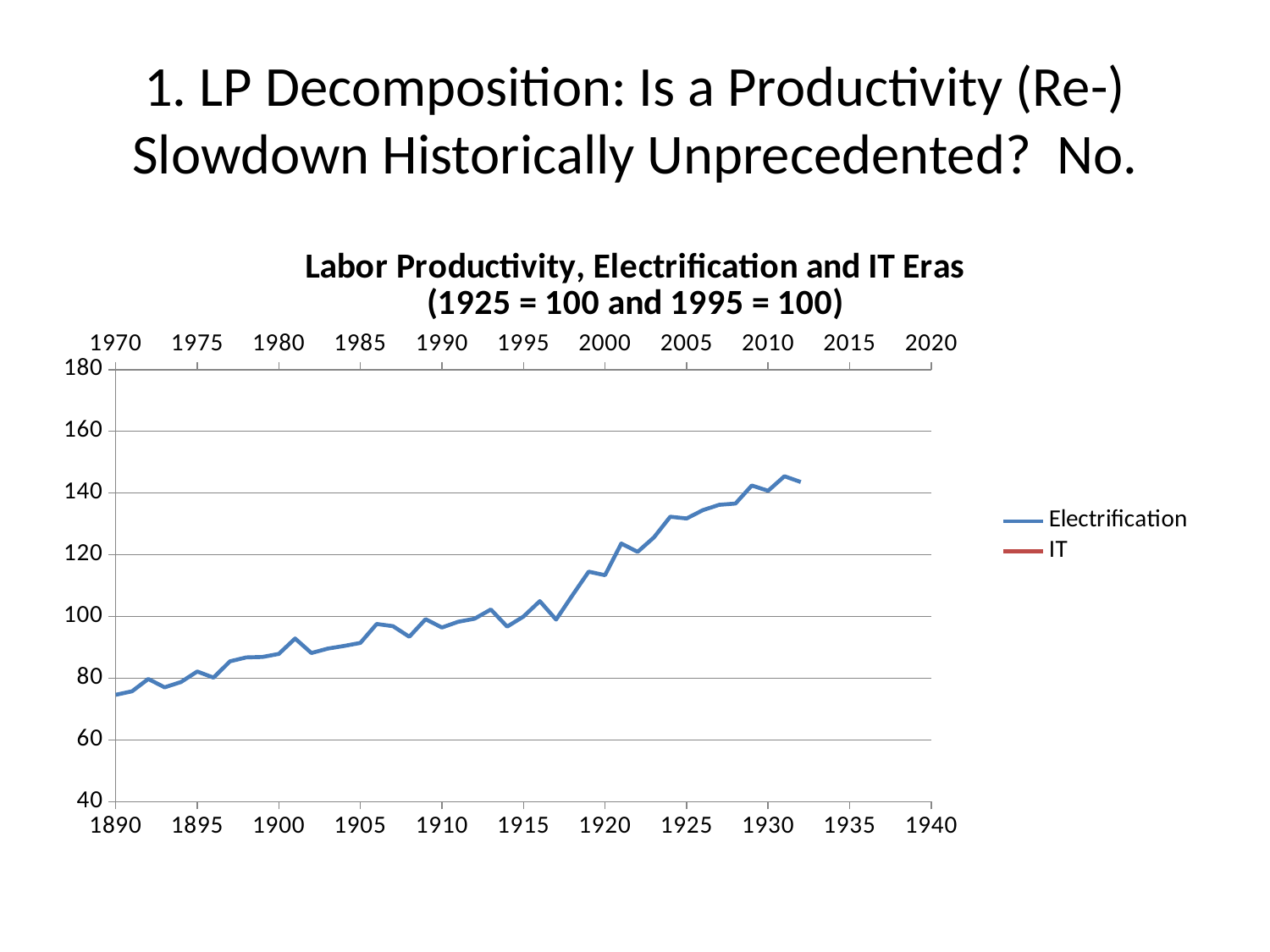
Is the Electrification value at 1900 greater or less than 100? less Is the Electrification value at 1920 greater or less than 100? greater Which is larger, the Electrification value at 1900 or at 1925? 1925 Which year has the lowest Electrification value on the chart? 1890 Does the Electrification line generally rise or fall from 1890 to 1932? rise How many series does the legend list? 2 What kind of chart is shown on the slide? line chart What are the two series named in the legend? Electrification and IT What is the title of the chart? Labor Productivity, Electrification and IT Eras (1925 = 100 and 1995 = 100) Is the Electrification value at 1932 greater or less than 160? less